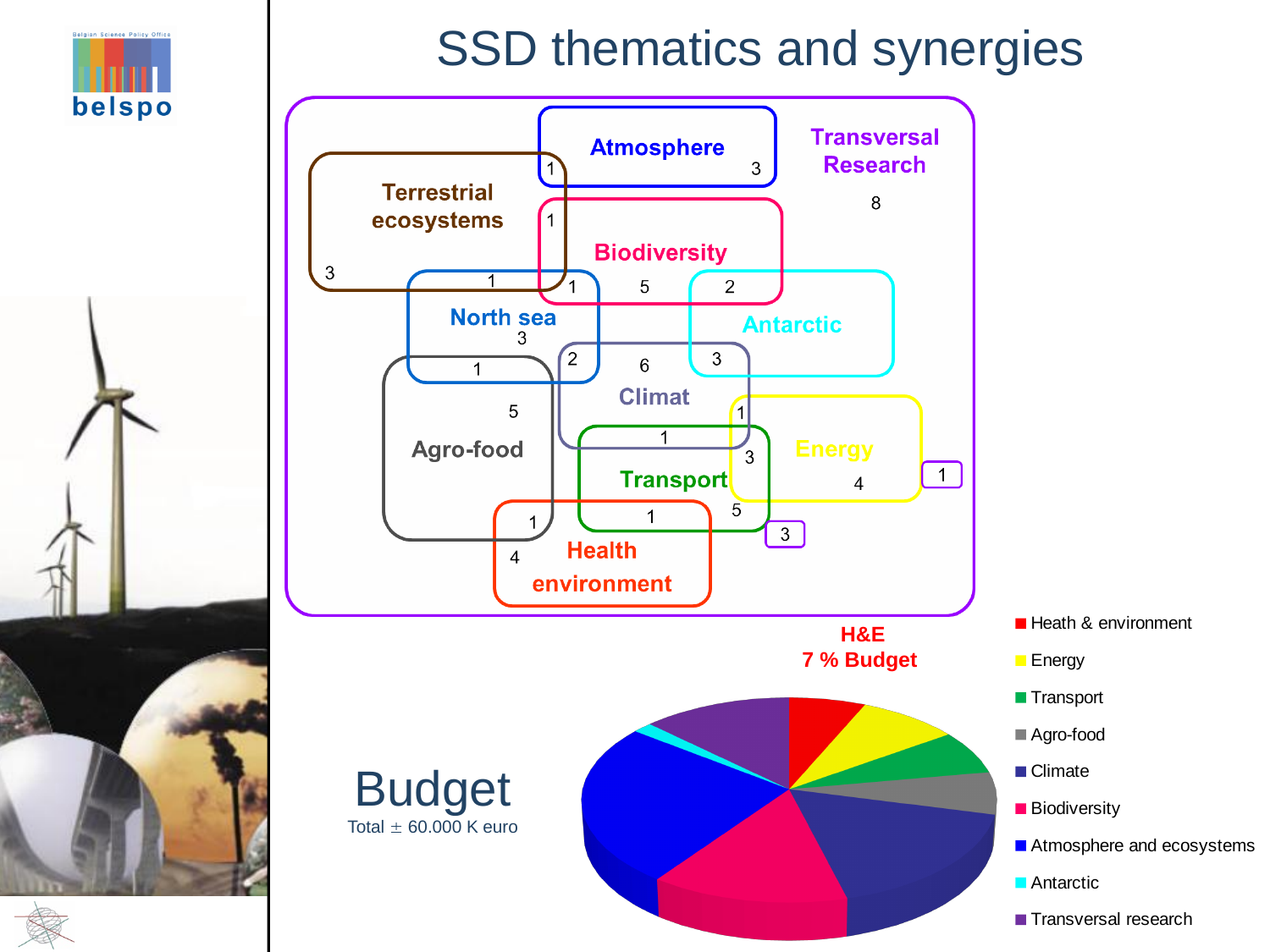
In the Budget pie chart, which slice is larger: Agro-food or Antarctic? Agro-food Which category has the smallest slice in the Budget pie chart? Antarctic Which category has the largest slice in the Budget pie chart? Atmosphere and ecosystems What total budget is stated below the title of the Budget pie chart? ± 60.000 K euro In the Budget pie chart, which slice is larger: Atmosphere and ecosystems or Transversal research? Atmosphere and ecosystems In the Budget pie chart, what share of the budget is labelled for H&E? 7 % In the Budget pie chart, which slice is larger: Climate or Energy? Climate How many categories does the legend of the Budget pie chart list? 9 What kind of chart is the Budget chart on the slide? pie chart What colour represents Energy in the Budget pie chart? yellow